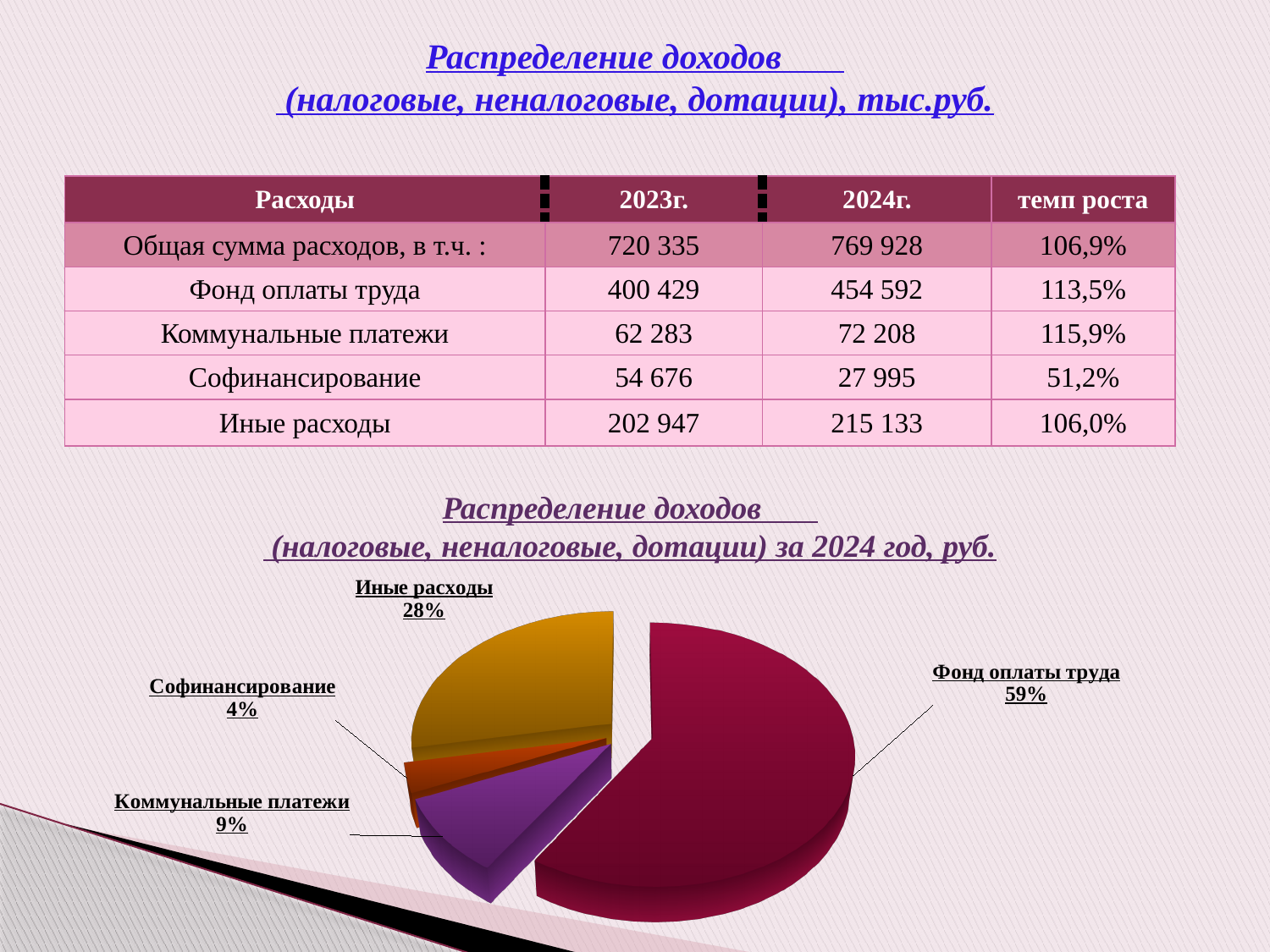
What is the difference in percentage points between the Фонд оплаты труда slice and the Иные расходы slice? 31 What share of the pie does Коммунальные платежи have? 9% What kind of chart is shown on the slide? pie chart Which year does the pie chart title say the data is for? 2024 Which category has the largest slice of the pie? Фонд оплаты труда How many slices does the pie chart have? 4 What share of the pie does Иные расходы have? 28% What is the combined share of the Коммунальные платежи and Софинансирование slices? 13% Which category has the smallest slice of the pie? Софинансирование What share of the pie does Софинансирование have? 4% Which slice is larger, Коммунальные платежи or Софинансирование? Коммунальные платежи